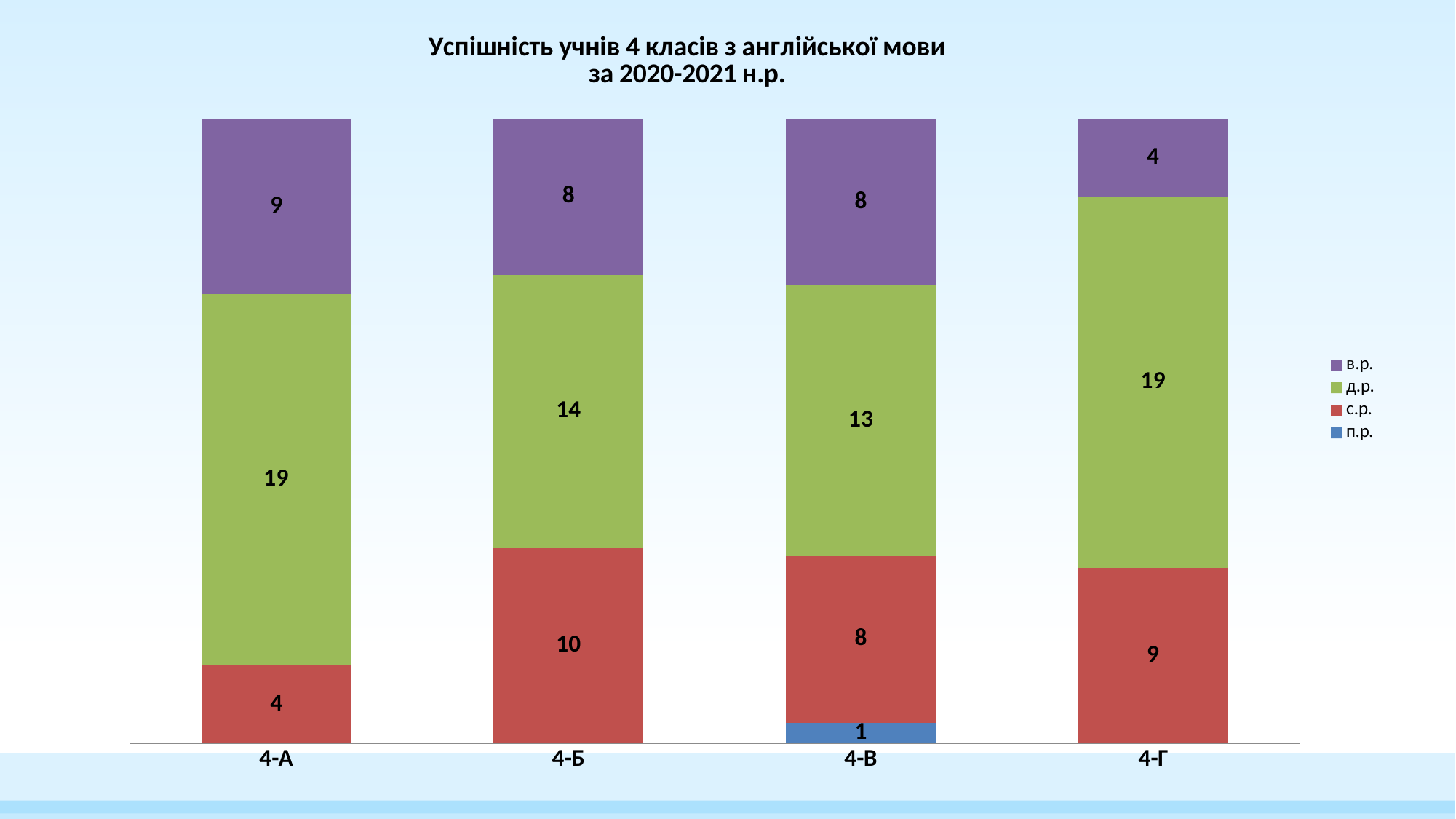
How many series does the legend list? 4 What is the value of п.р. for class 4-В? 1 Which is larger: с.р. for 4-Б or с.р. for 4-Г? с.р. for 4-Б How many classes are shown on the x axis? 4 Which class has the lowest value for с.р.? 4-А What is the value of с.р. for class 4-Б? 10 What is the difference between the д.р. values for 4-А and 4-В? 6 What is the total of all segments in the bar for 4-В? 30 What kind of chart is shown? Stacked bar chart Which class has the highest value for в.р.? 4-А What is the value of в.р. for class 4-Г? 4 What is the value of д.р. for class 4-А? 19